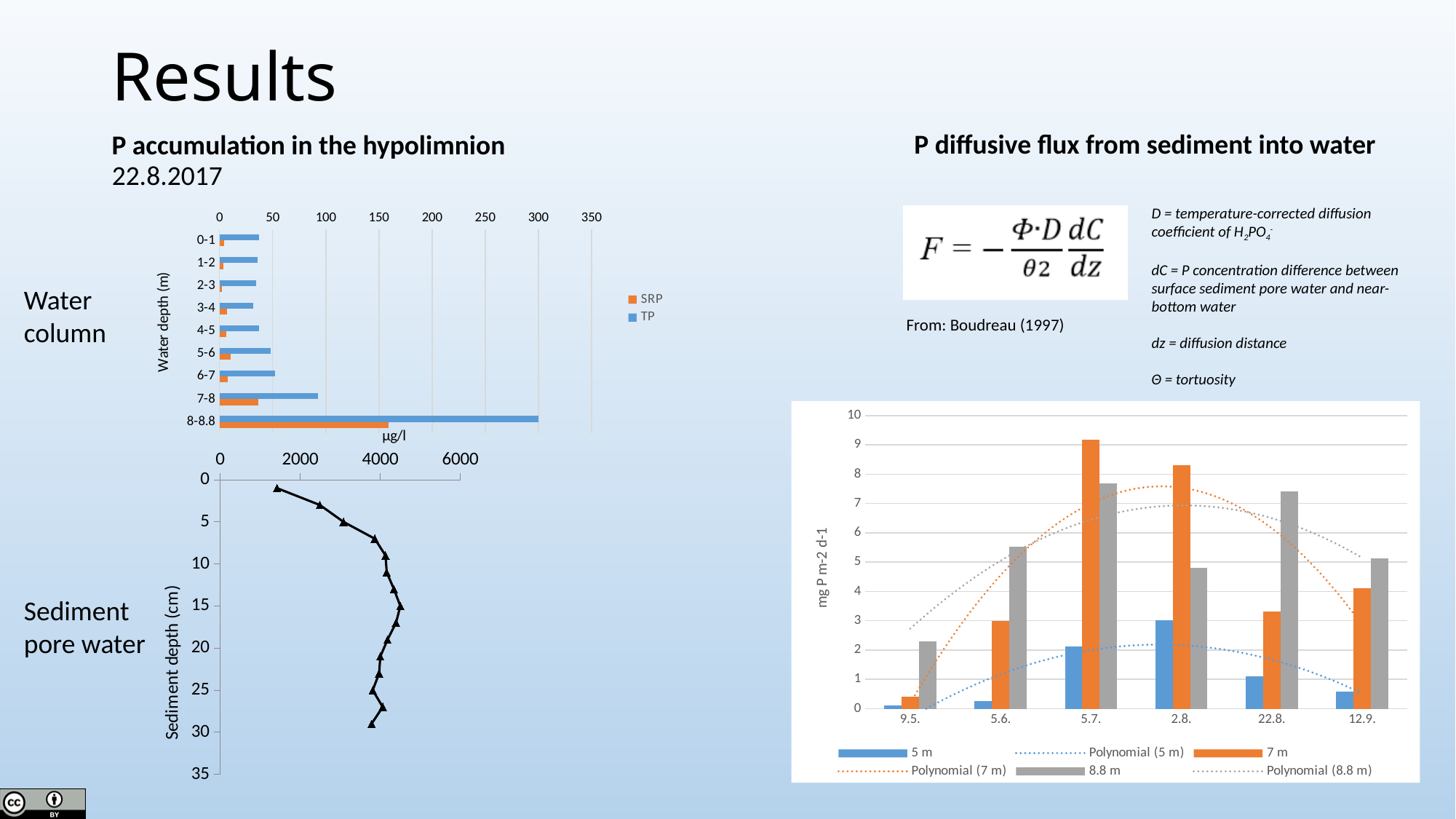
In the 'P diffusive flux from sediment into water' chart, on 22.8., which is larger: the 7 m bar or the 8.8 m bar? 8.8 m In the sediment pore water chart, what kind of chart is used? line chart In the 'P accumulation in the hypolimnion' chart, what kind of chart is used? bar chart In the 'P accumulation in the hypolimnion' chart, which water depth has the highest TP value? 8-8.8 In the 'P diffusive flux from sediment into water' chart, on which date is the 7 m bar highest? 5.7. In the 'P diffusive flux from sediment into water' chart, how many entries does the legend list? 6 In the 'P accumulation in the hypolimnion' chart, how many water depth categories are shown? 9 In the 'P accumulation in the hypolimnion' chart, what unit is shown on the horizontal axis? µg/l In the 'P diffusive flux from sediment into water' chart, how many dates are shown on the x axis? 6 In the 'P accumulation in the hypolimnion' chart, is the SRP value for 8-8.8 m greater or less than 100? greater In the 'P accumulation in the hypolimnion' chart, is the TP value for 8-8.8 m greater or less than 250? greater In the 'P accumulation in the hypolimnion' chart, how many series does the legend list? 2